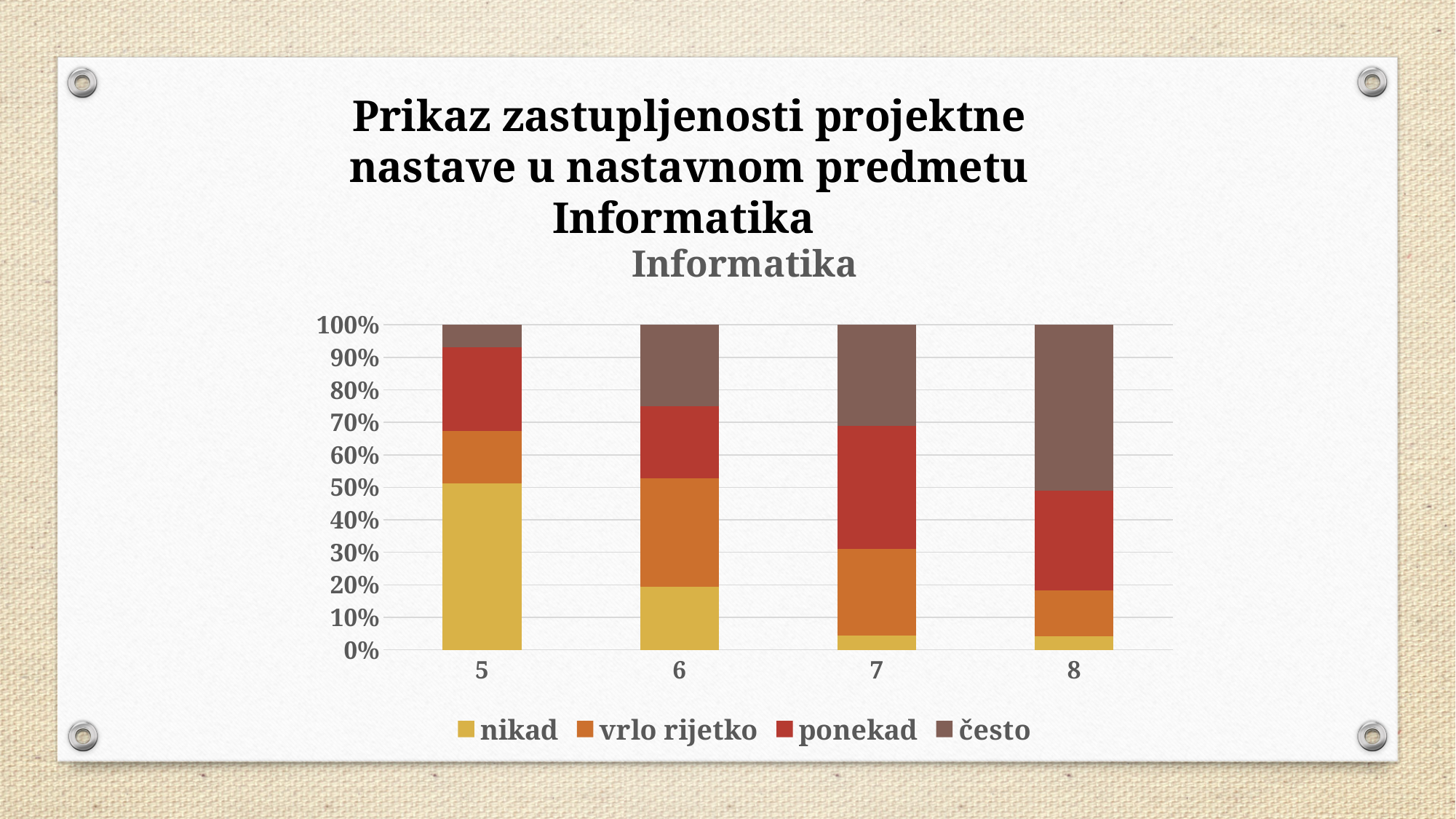
How many categories are shown on the x axis of the chart? 4 What is the title shown directly above the chart area? Informatika What are the series names listed in the legend? nikad, vrlo rijetko, ponekad, često Which category has the largest 'nikad' segment? 5 Is the 'nikad' segment larger for category 5 or category 6? 5 What kind of chart is shown on the slide? Stacked bar chart How many series does the legend list? 4 Is the 'nikad' segment for category 5 greater or less than 40%? greater Which category has the smallest 'često' segment? 5 Does the 'nikad' segment rise or fall from category 5 to category 8? fall Which category has the largest 'često' segment? 8 Is the 'nikad' segment for category 8 greater or less than 10%? less